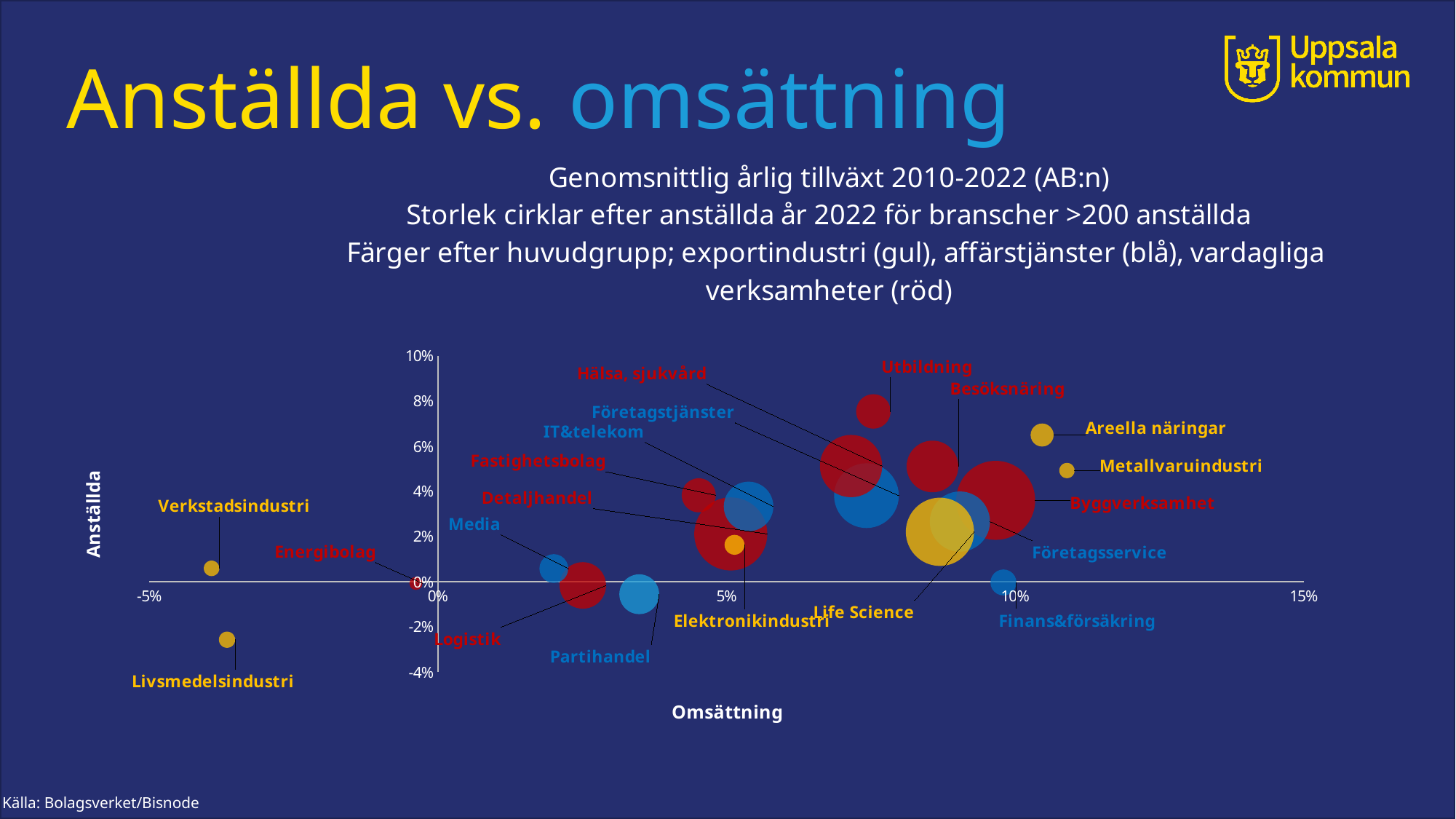
Which industry has the lowest value on the Anställda (y) axis? Livsmedelsindustri Is the Omsättning value for Verkstadsindustri greater or less than 0%? less Is the Anställda value for Utbildning greater or less than 6%? greater Is the Omsättning value for Metallvaruindustri greater or less than 5%? greater Which industry has the highest value on the Anställda (y) axis? Utbildning What is the label of the horizontal axis of the chart? Omsättning Which has the higher Omsättning value, Areella näringar or Verkstadsindustri? Areella näringar How many industries (bubbles) are plotted on the chart? 20 What kind of chart is shown on the slide? Bubble chart Which has the higher Anställda value, Utbildning or Hälsa, sjukvård? Utbildning